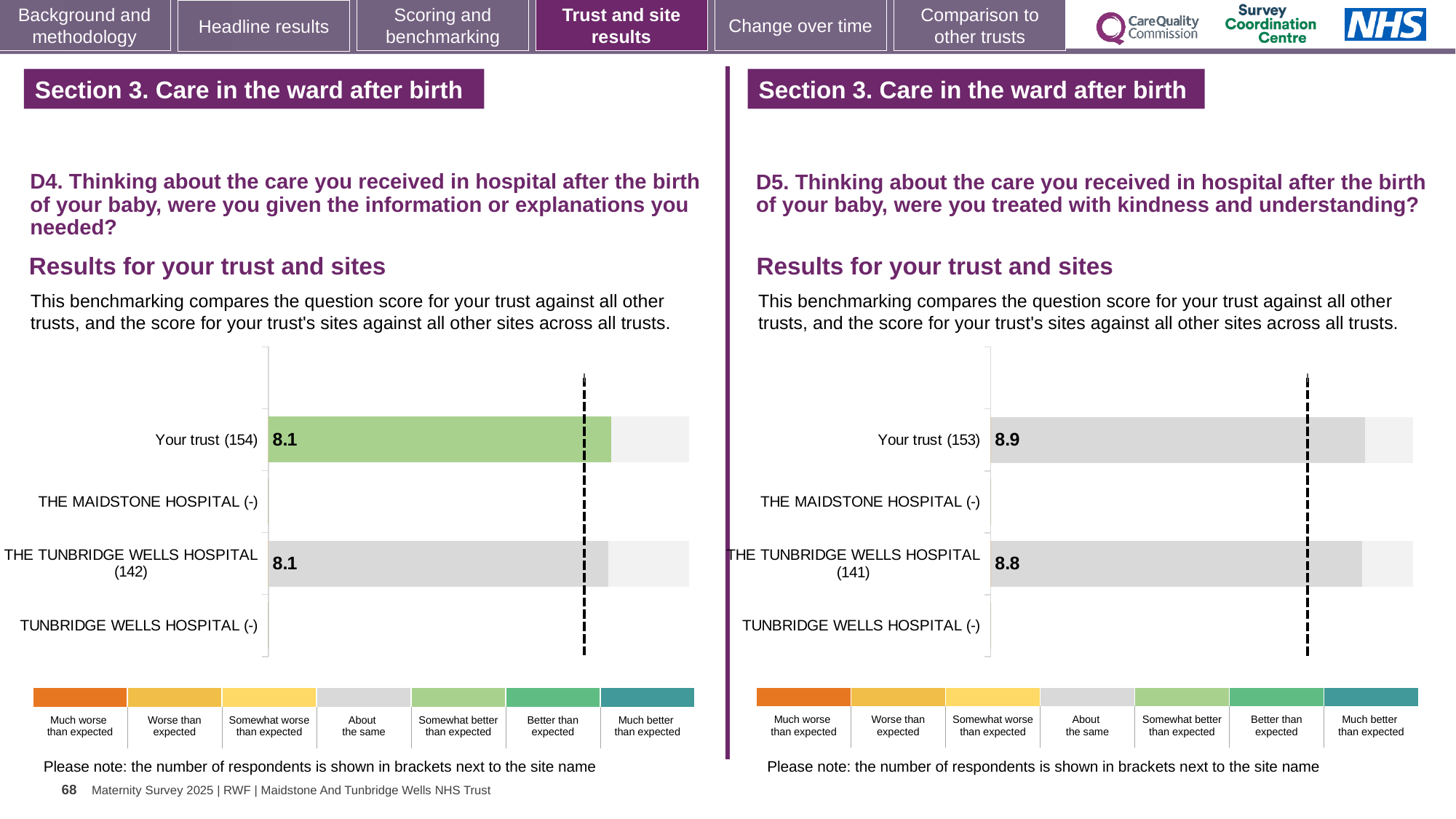
In the left chart (D4), how many respondents are shown in brackets for Your trust? 154 In the left chart (D4), is the score for Your trust (154) greater or less than the score for Your trust (153) in the right chart (D5)? less In the right chart (D5), what is the score for Your trust (153)? 8.9 In the left chart (D4), what is the score for THE TUNBRIDGE WELLS HOSPITAL (142)? 8.1 In the left chart (D4), what is the score for Your trust (154)? 8.1 In the left chart (D4), what is the difference between the score for Your trust (154) and the score for THE TUNBRIDGE WELLS HOSPITAL (142)? 0 What kind of chart is used on the left side of the slide (D4)? Bar chart In the right chart (D5), which has the higher score: Your trust (153) or THE TUNBRIDGE WELLS HOSPITAL (141)? Your trust (153) In the right chart (D5), what is the score for THE TUNBRIDGE WELLS HOSPITAL (141)? 8.8 In the right chart (D5), what is the difference between the score for Your trust (153) and the score for THE TUNBRIDGE WELLS HOSPITAL (141)? 0.1 In the left chart (D4), how many categories are listed on the vertical axis? 4 In the right chart (D5), how many respondents are shown in brackets for THE TUNBRIDGE WELLS HOSPITAL? 141